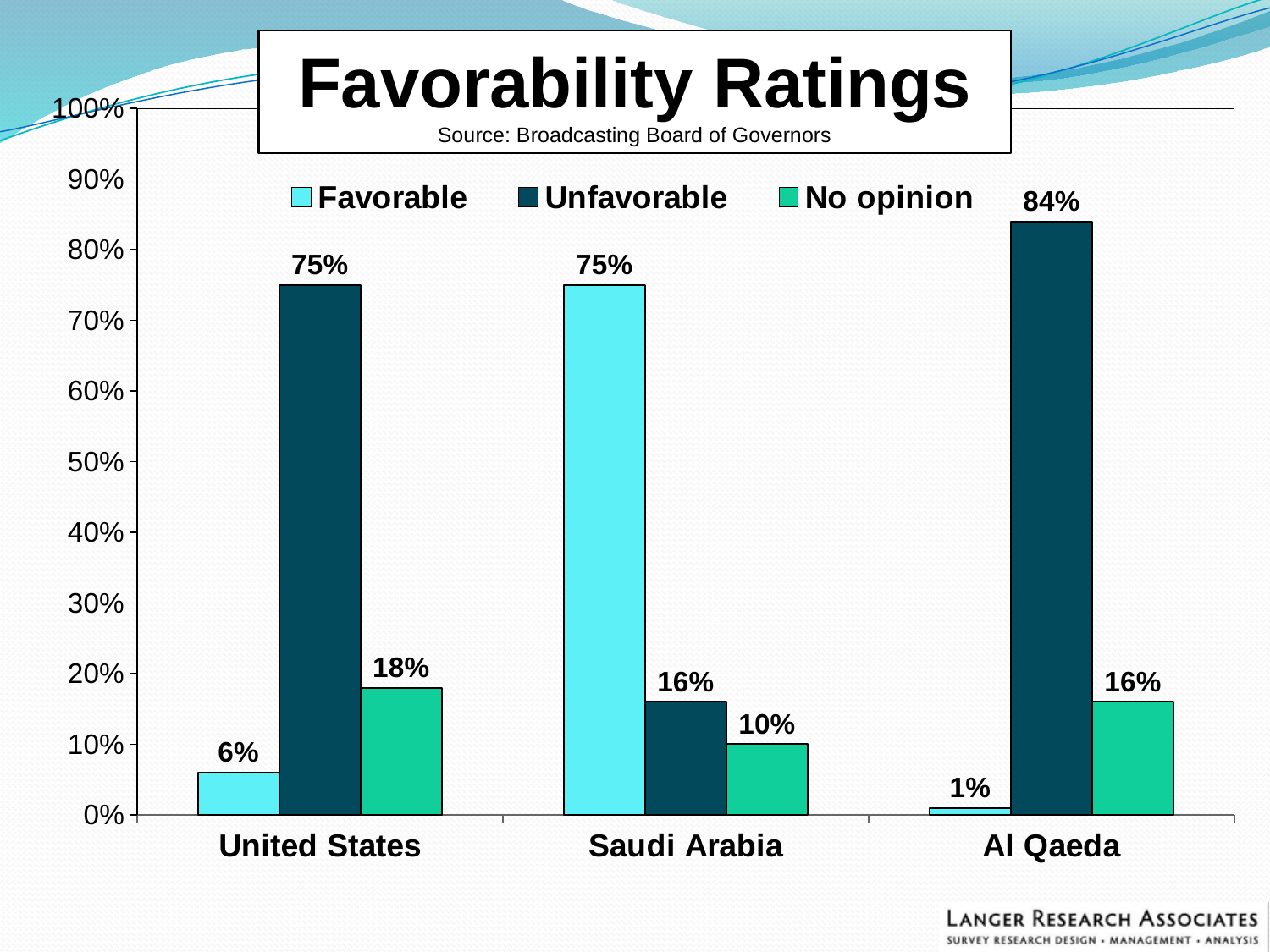
What is the No opinion value for Saudi Arabia? 10% What is the difference between the Unfavorable ratings for Al Qaeda and the United States? 9% How many categories are shown on the x axis? 3 What is the Favorable rating for the United States? 6% Which category has the highest Favorable rating? Saudi Arabia What kind of chart is shown on the slide? Bar chart What source is cited for the chart? Broadcasting Board of Governors How many series does the legend list? 3 What is the Unfavorable rating for Al Qaeda? 84% What is the title of the chart? Favorability Ratings Which category has the lowest Favorable rating? Al Qaeda Which is larger: the No opinion value for the United States or for Saudi Arabia? United States